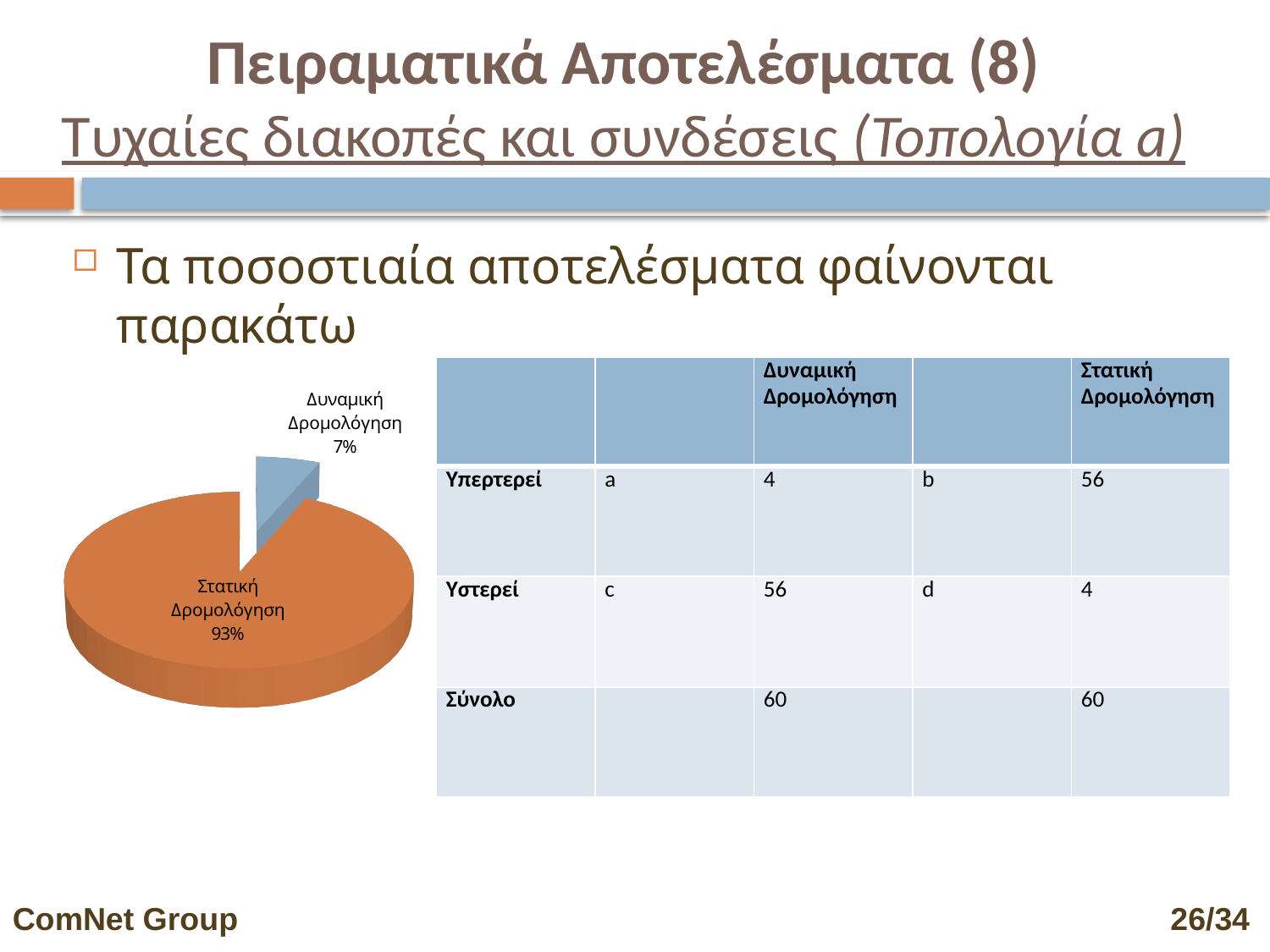
What share of the pie does Δυναμική Δρομολόγηση have? 7% What share of the pie does Στατική Δρομολόγηση have? 93% What colour is the Στατική Δρομολόγηση slice of the pie chart? orange Which is larger in the pie chart, Δυναμική Δρομολόγηση or Στατική Δρομολόγηση? Στατική Δρομολόγηση Which slice of the pie chart is the smallest? Δυναμική Δρομολόγηση What kind of chart is shown on the slide? pie chart Which slice of the pie chart is the largest? Στατική Δρομολόγηση How many slices does the pie chart have? 2 What is the difference in percentage points between the Στατική Δρομολόγηση slice and the Δυναμική Δρομολόγηση slice? 86 What colour is the Δυναμική Δρομολόγηση slice of the pie chart? blue